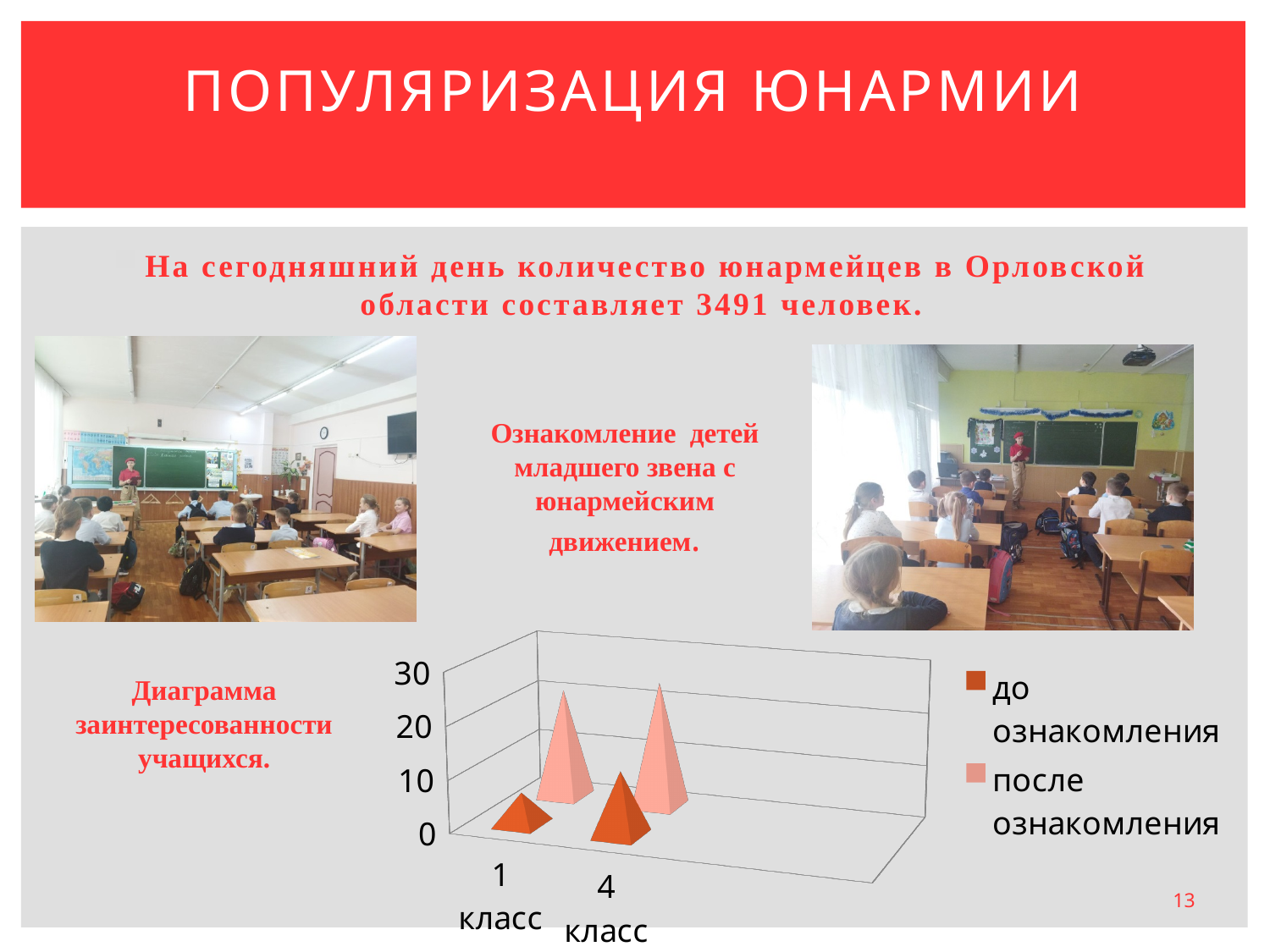
What caption is given for the chart on the left side of the slide? Диаграмма заинтересованности учащихся. How many categories (classes) are shown on the x axis of the chart? 2 Which bar in the chart is the lowest? до ознакомления, 1 класс Which class has the higher value for до ознакомления? 4 класс Which two series are listed in the chart legend? до ознакомления, после ознакомления For 1 класс, which is larger: до ознакомления or после ознакомления? после ознакомления Is the value for после ознакомления in 1 класс greater or less than 10? greater Is the value for после ознакомления in 4 класс greater or less than 10? greater What kind of chart is shown on the slide? bar chart For 4 класс, which is larger: до ознакомления or после ознакомления? после ознакомления Is the value for до ознакомления in 1 класс greater or less than 10? less How many series does the chart legend list? 2